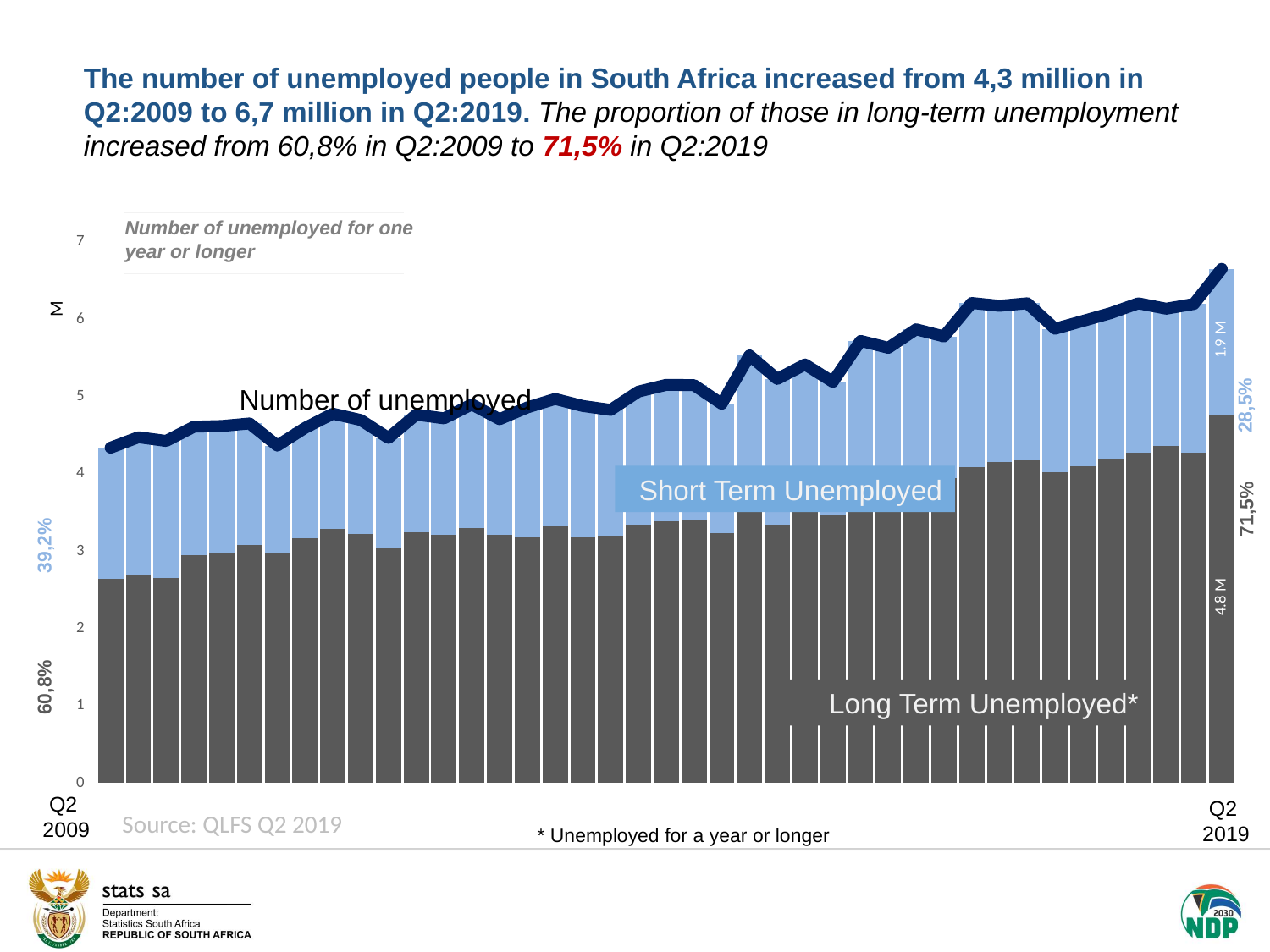
What proportion of the unemployed were in long-term unemployment in Q2:2019? 71,5% How many people were long-term unemployed in Q2:2019 according to the data label? 4,8 M Is the number of long-term unemployed in Q2:2009 greater or less than 3 million? less What proportion of the unemployed were in short-term unemployment in Q2:2009? 39,2% In Q2:2019, which is larger: the long-term unemployed or the short-term unemployed? Long Term Unemployed What kind of chart is shown on the slide? A stacked bar chart with a line overlay What is the total number of unemployed in Q2:2019, adding the long-term (4,8 M) and short-term (1,9 M) labels? 6,7 M Does the 'Number of unemployed' line generally rise or fall from Q2:2009 to Q2:2019? Rise How many people were short-term unemployed in Q2:2019 according to the data label? 1,9 M What is the source cited for the chart? QLFS Q2 2019 What proportion of the unemployed were in long-term unemployment in Q2:2009? 60,8% By how many percentage points did the long-term unemployment share change between Q2:2009 (60,8%) and Q2:2019 (71,5%)? 10,7 percentage points